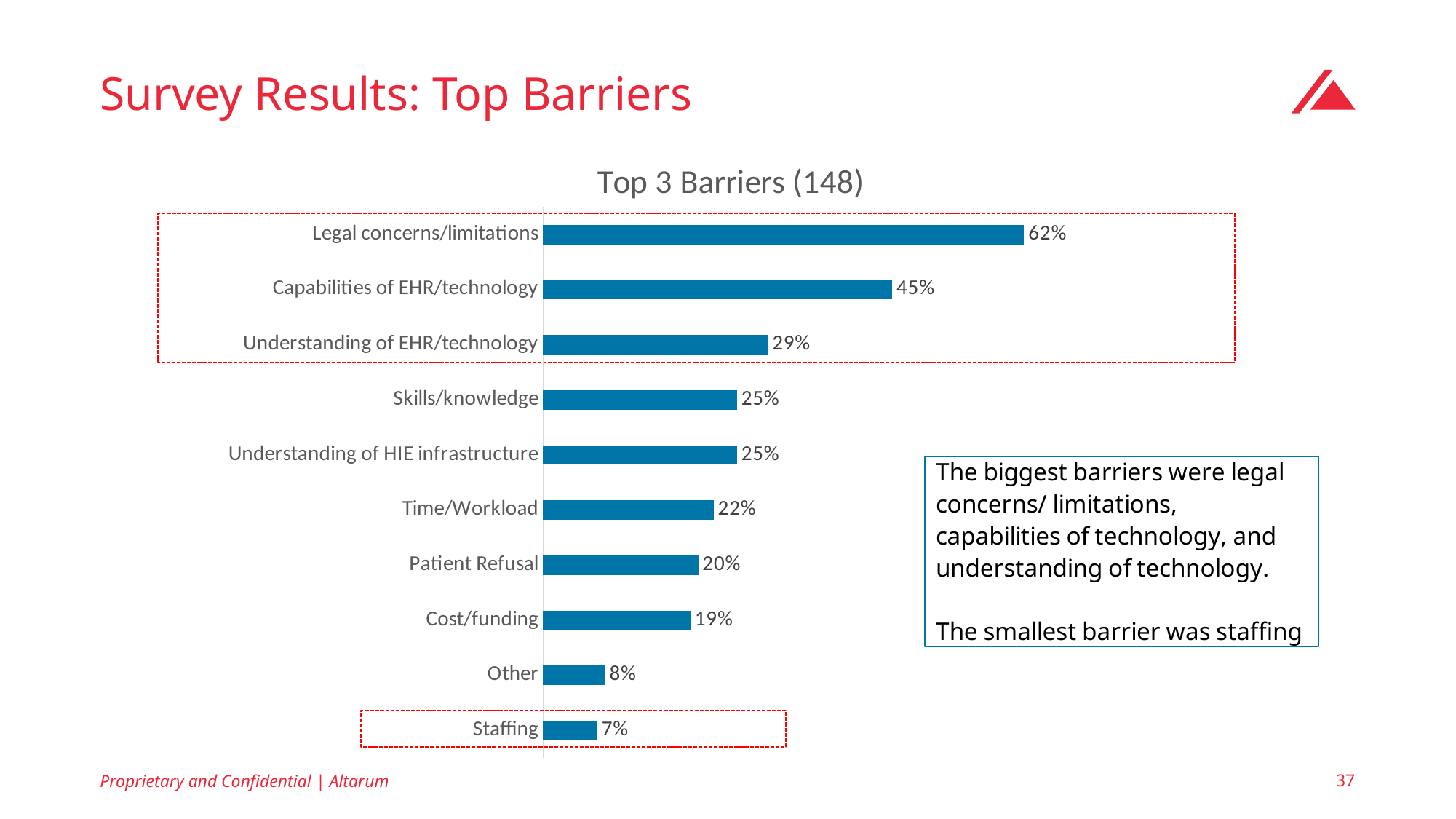
What is the value for Capabilities of EHR/technology? 45% What is the title of the chart? Top 3 Barriers (148) Which barrier has the highest value? Legal concerns/limitations What is the difference between the values for Understanding of EHR/technology and Staffing? 22% Which is larger, the value for Time/Workload or the value for Cost/funding? Time/Workload Which barrier has the lowest value? Staffing How many barrier categories are shown in the chart? 10 What is the value for Patient Refusal? 20% What is the value for Other? 8% What is the difference between the values for Legal concerns/limitations and Capabilities of EHR/technology? 17% What kind of chart is shown on the slide? Bar chart What is the value for Legal concerns/limitations? 62%